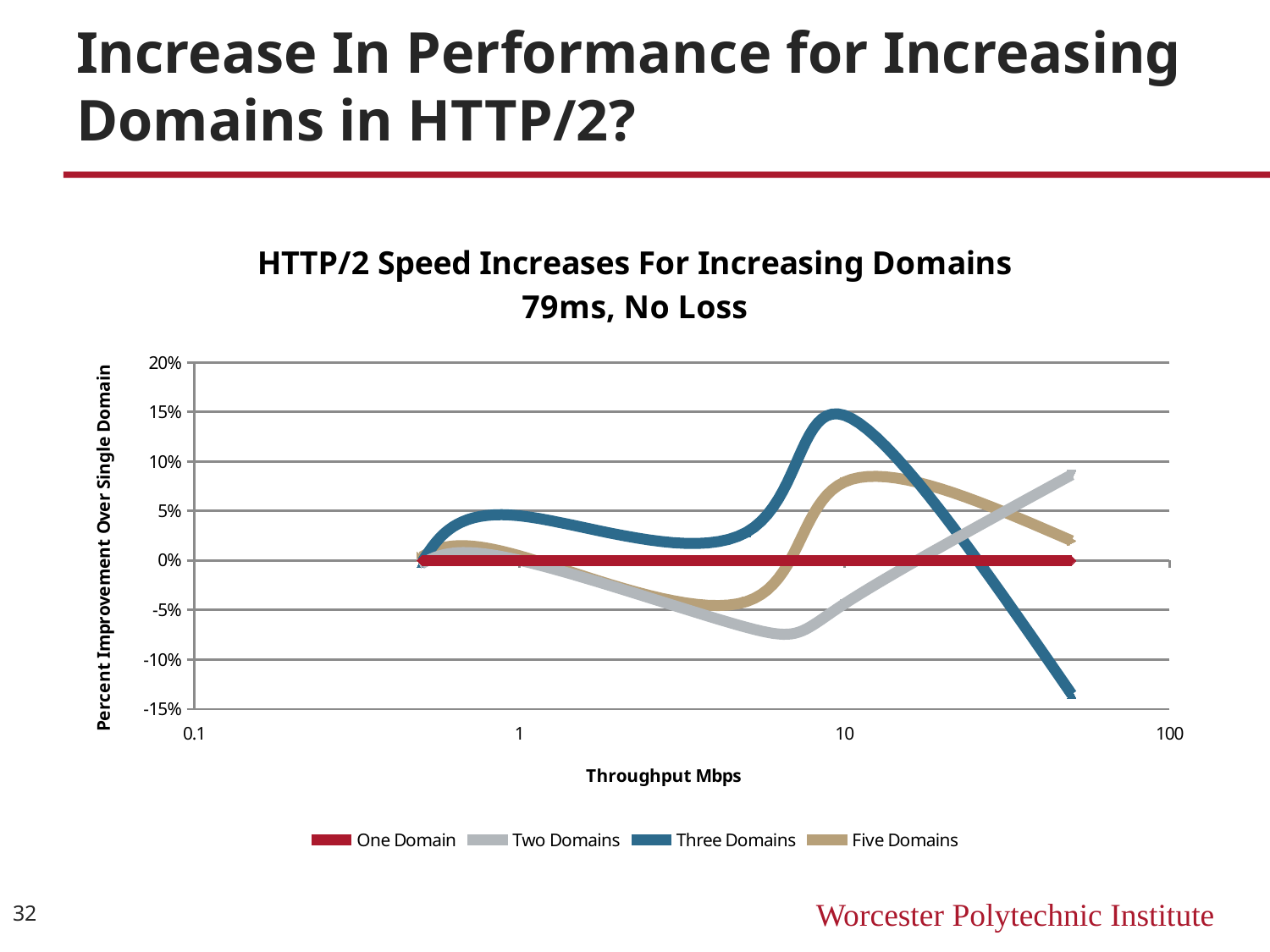
At the right-hand end of the chart (around 50 Mbps), which series has the higher value: Two Domains or Three Domains? Two Domains Which series is drawn in red in the legend? One Domain Which series reaches the highest value anywhere on the chart? Three Domains What is the title of the x axis? Throughput Mbps Which series reaches the lowest value anywhere on the chart? Three Domains What kind of chart is shown on the slide? line chart At around 10 Mbps, which series has the higher value: Three Domains or Five Domains? Three Domains Does the Two Domains series rise or fall between 10 Mbps and the right-hand end of the chart? rise How many series does the legend list? 4 Is the peak value of the Five Domains series greater or less than 5%? greater Is the peak value of the Three Domains series greater or less than 10%? greater Is the value of the Three Domains series at its right-hand end (around 50 Mbps) greater or less than -10%? less